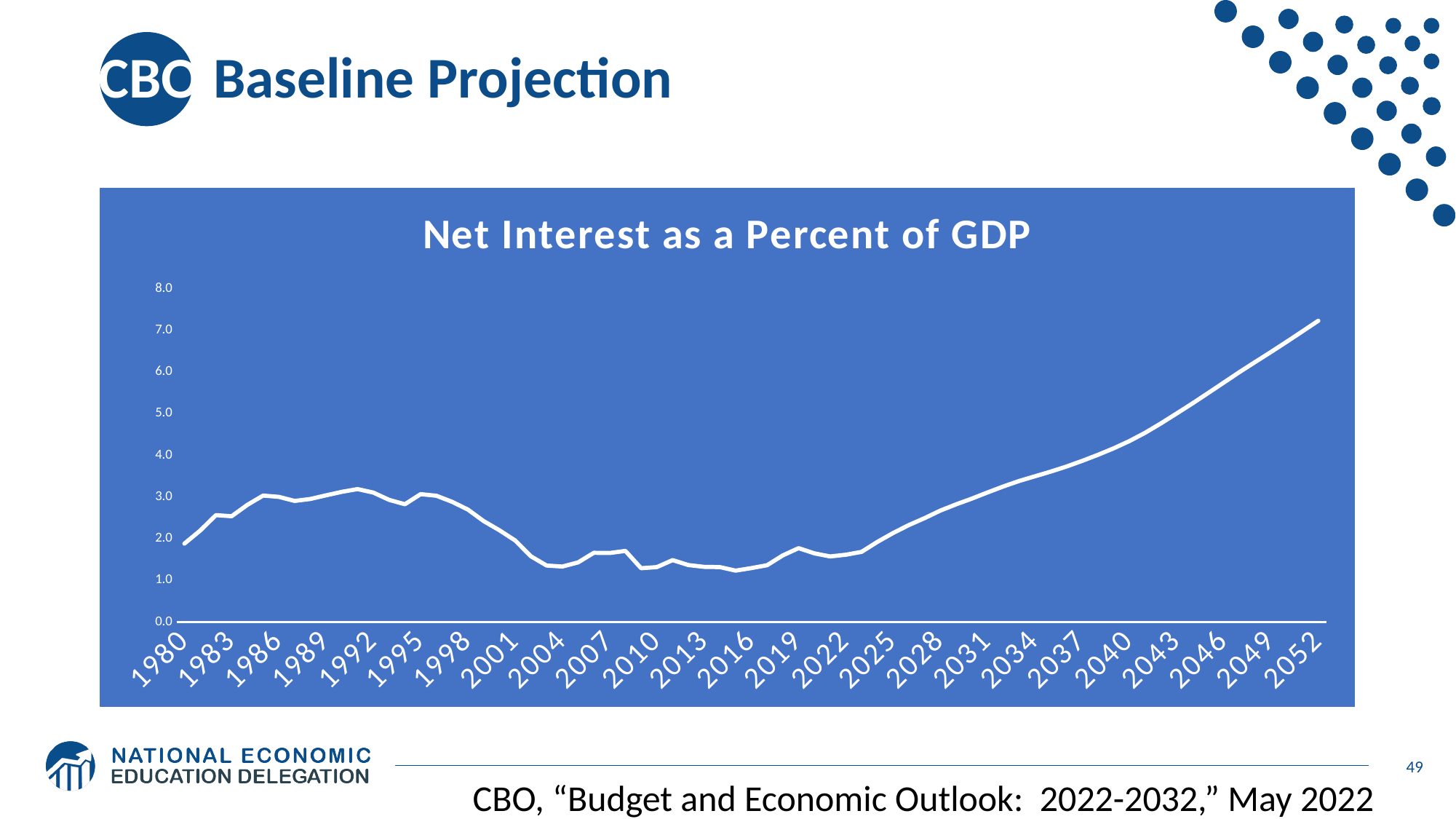
Is the value for 2016 greater or less than 2.0? less Is the value for 2025 greater or less than 3.0? less Is the value for 2052 greater or less than 7.0? greater Which has the larger value, 1980 or 2052? 2052 Do the values rise or fall from 2025 to 2052? rise Do the values rise or fall from 1992 to 2004? fall What is the title of the chart? Net Interest as a Percent of GDP What kind of chart is shown on the slide? line chart Which year has the highest value on the chart? 2052